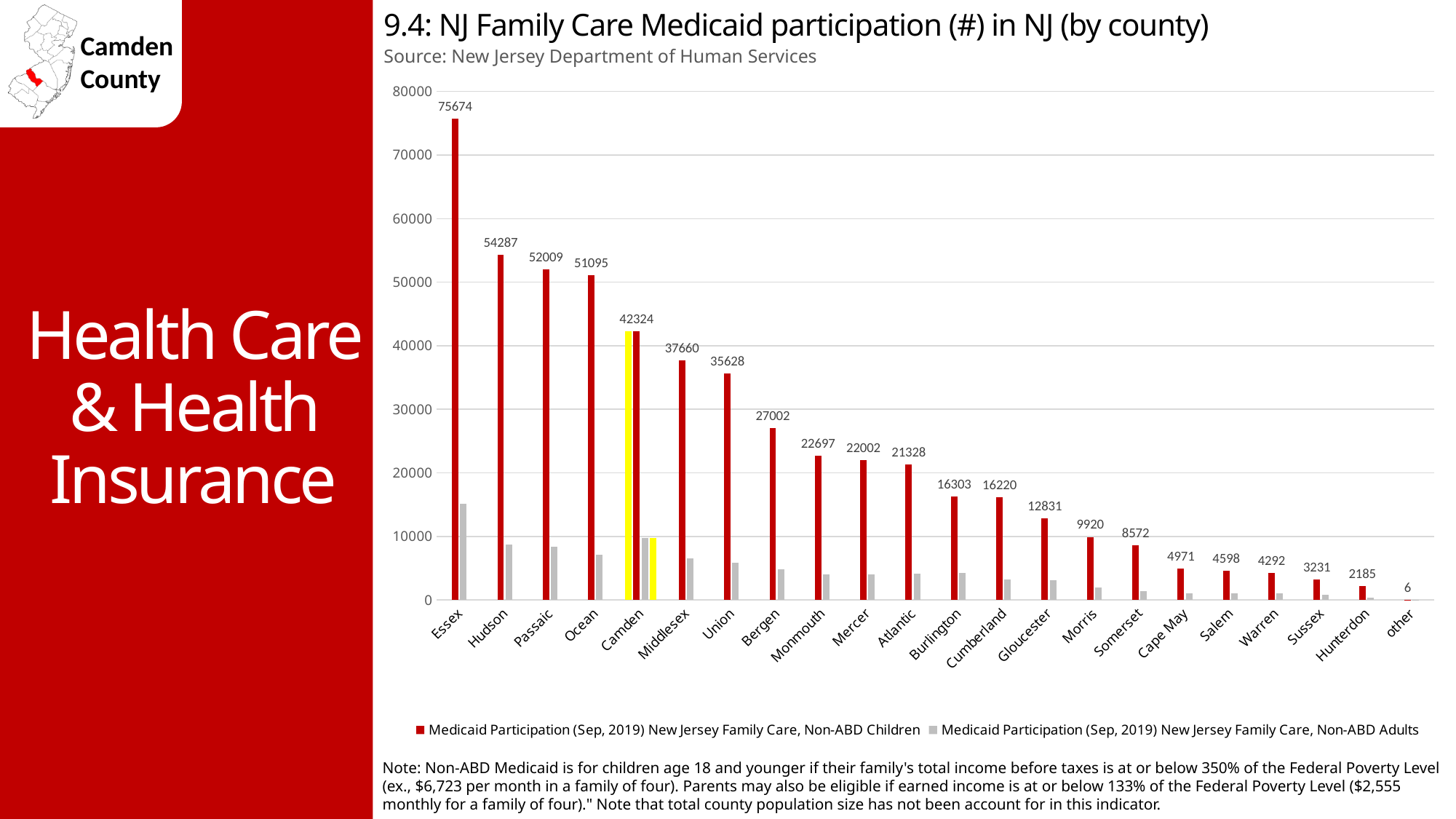
Which has a larger Non-ABD Children value, Middlesex or Union? Middlesex What kind of chart is shown on the slide? Bar chart Is the Non-ABD Adults value for Essex greater or less than 10000? greater How many series does the legend list? 2 What is the Non-ABD Children Medicaid participation value for Camden? 42324 What is the Non-ABD Children Medicaid participation value for Gloucester? 12831 What is the Non-ABD Children Medicaid participation value for Essex? 75674 How many categories are shown on the x axis? 22 Which county has the lowest Non-ABD Children Medicaid participation (excluding 'other')? Hunterdon What is the difference between the Non-ABD Children values for Hudson and Passaic? 2278 Which county has the highest Non-ABD Children Medicaid participation? Essex